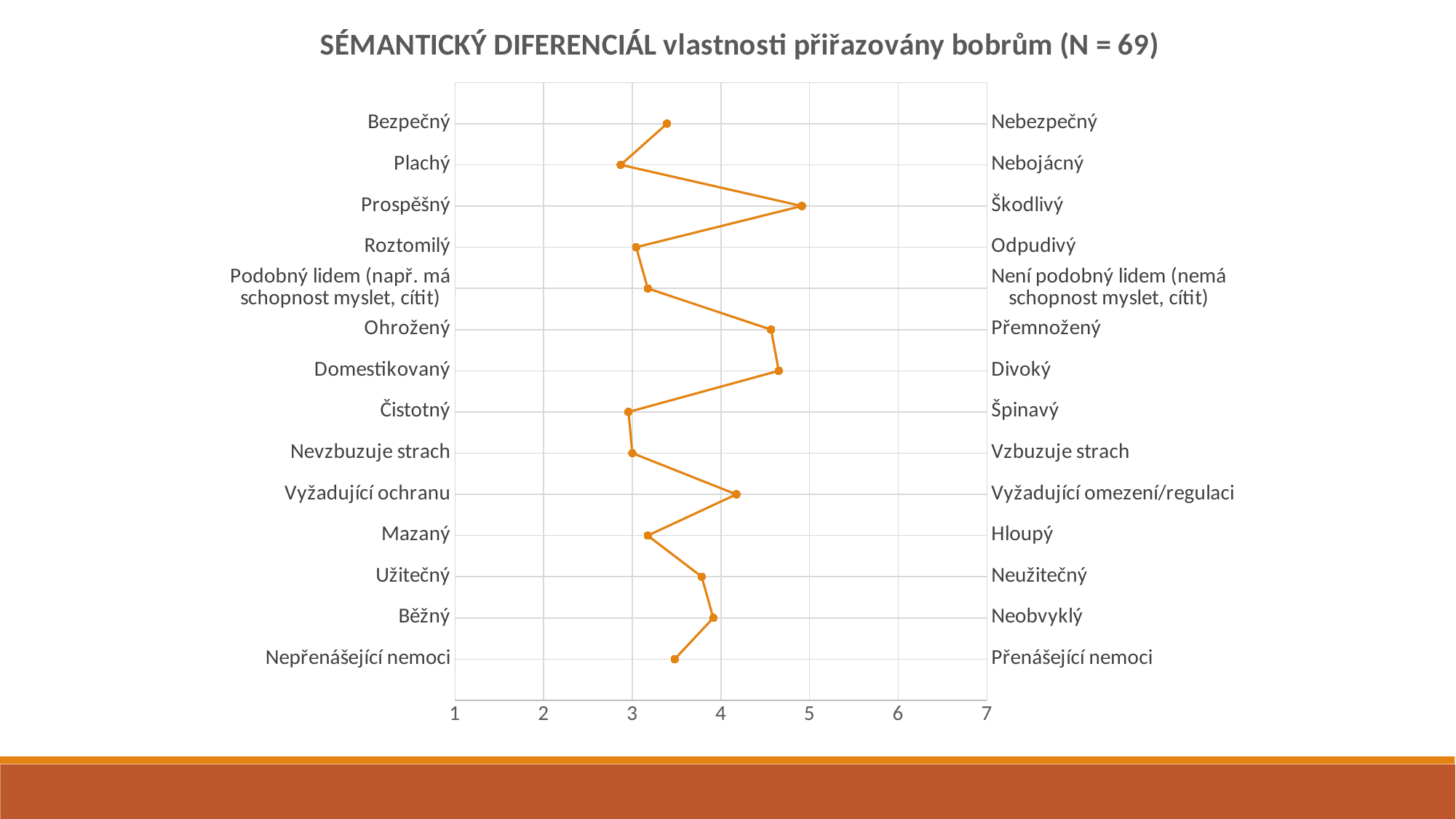
Which has the larger value, Prospěšný or Roztomilý? Prospěšný Is the value for Bezpečný greater or less than 4? less What is the range of the horizontal axis? 1 to 7 Is the value for Prospěšný greater or less than 4? greater What kind of chart is shown on the slide? Line chart Is the value for Domestikovaný greater or less than 4? greater What is the sample size (N) stated in the chart title? 69 How many attribute pairs (categories) are plotted on the chart? 14 Which has the larger value, Vyžadující ochranu or Mazaný? Vyžadující ochranu Which category has the highest value on the chart? Prospěšný / Škodlivý